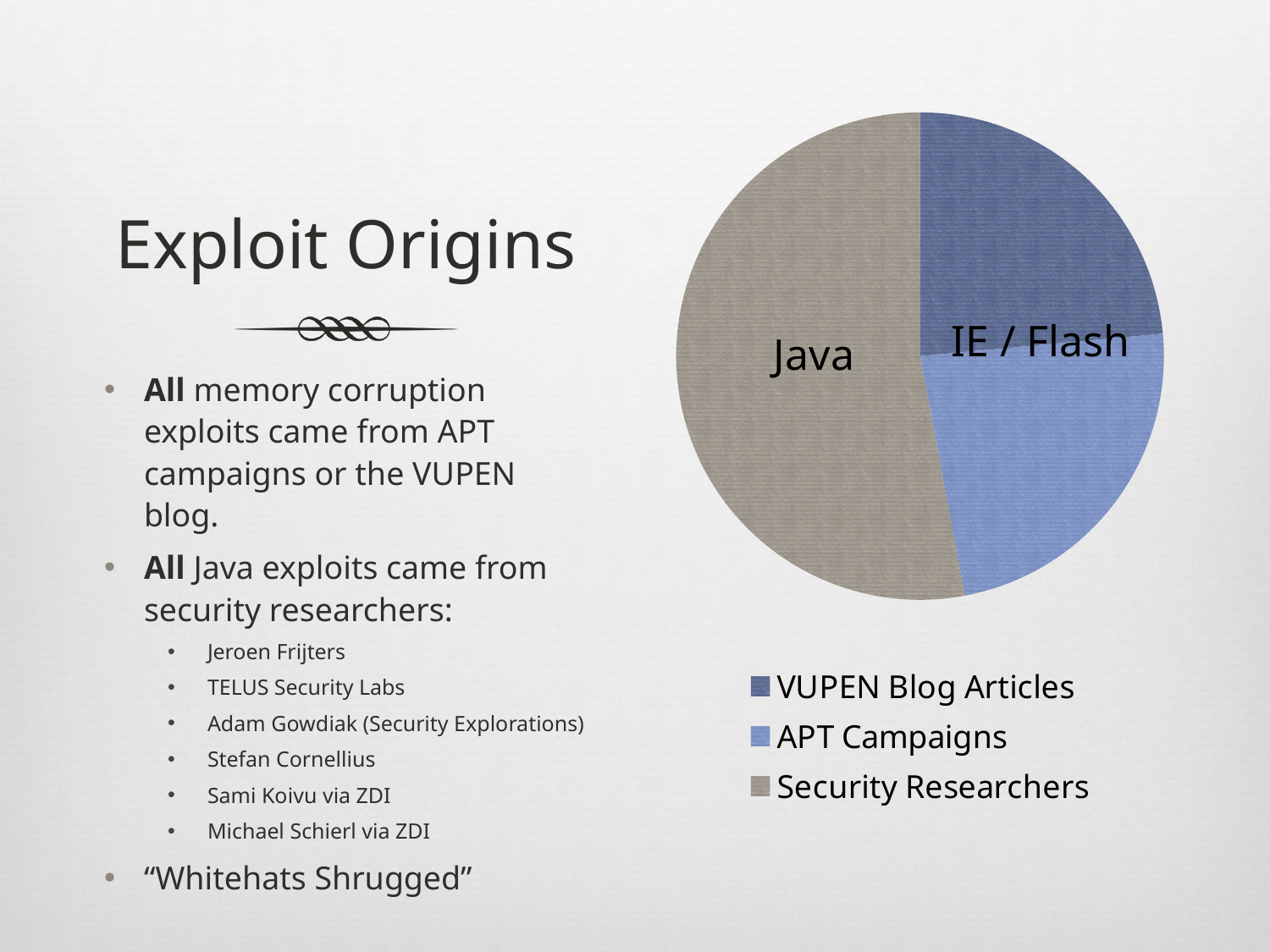
Which slice is larger, Security Researchers or VUPEN Blog Articles? Security Researchers What are the three categories listed in the pie chart's legend? VUPEN Blog Articles, APT Campaigns, Security Researchers Which category has the largest slice in the pie chart? Security Researchers How many entries does the legend of the pie chart list? 3 Which slice is larger, Security Researchers or APT Campaigns? Security Researchers What kind of chart is shown on the slide? pie chart Which text label is placed on the Security Researchers slice of the pie chart? Java How many slices does the pie chart have? 3